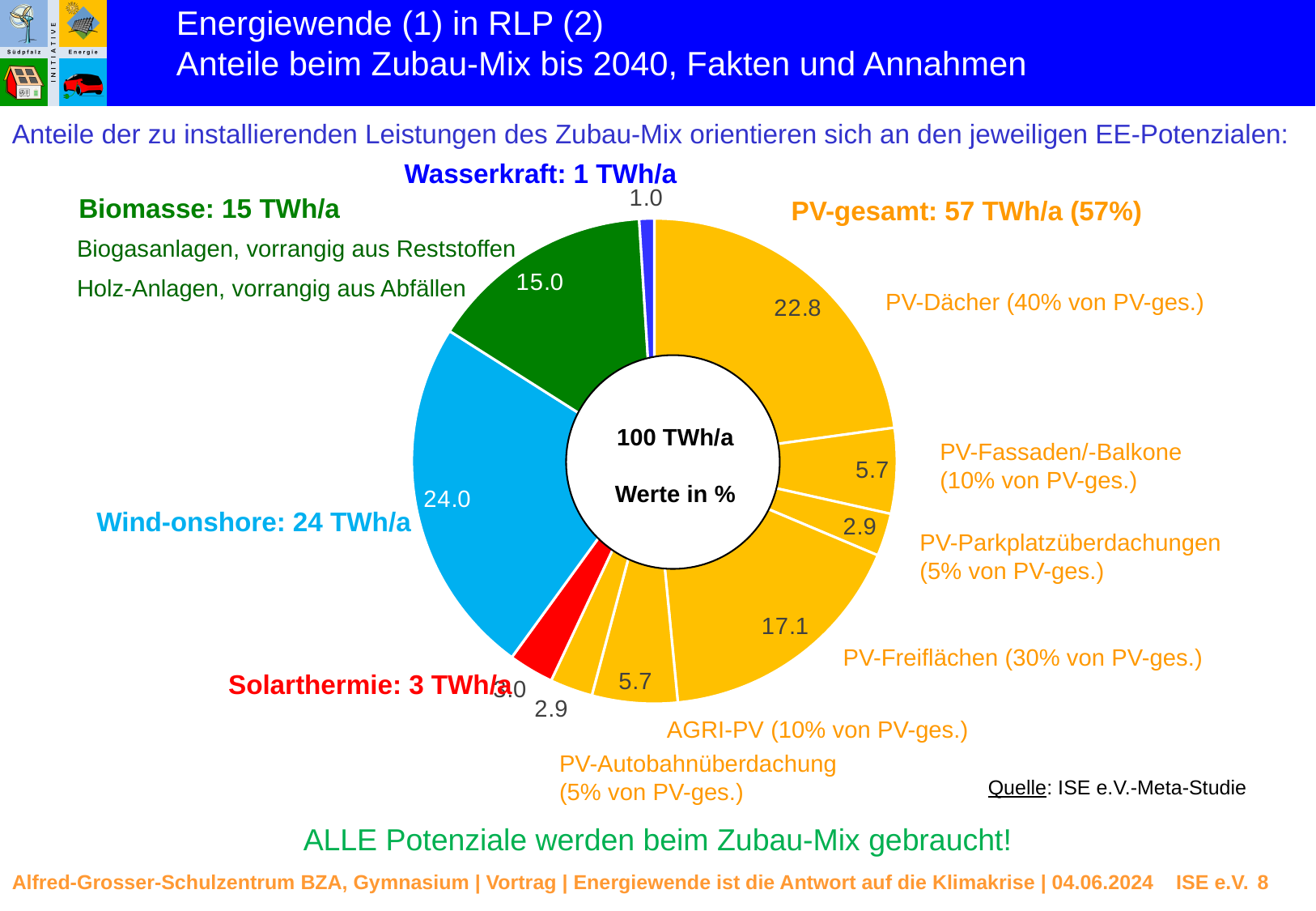
What is the value shown for Biomasse in the chart? 15.0 What text is written in the centre of the doughnut chart? 100 TWh/a, Werte in % Which slice of the chart has the smallest value? Wasserkraft What type of chart is shown on the slide? doughnut chart How many slices does the chart have? 10 Which slice of the chart has the largest value? Wind-onshore What is the value shown for Wasserkraft in the chart? 1.0 What is the value shown for PV-Dächer in the chart? 22.8 What is the value shown for PV-Freiflächen in the chart? 17.1 Which is larger, the value for PV-Freiflächen or the value for Biomasse? PV-Freiflächen What is the value shown for Wind-onshore in the chart? 24.0 What is the difference between the values for Wind-onshore and PV-Dächer? 1.2